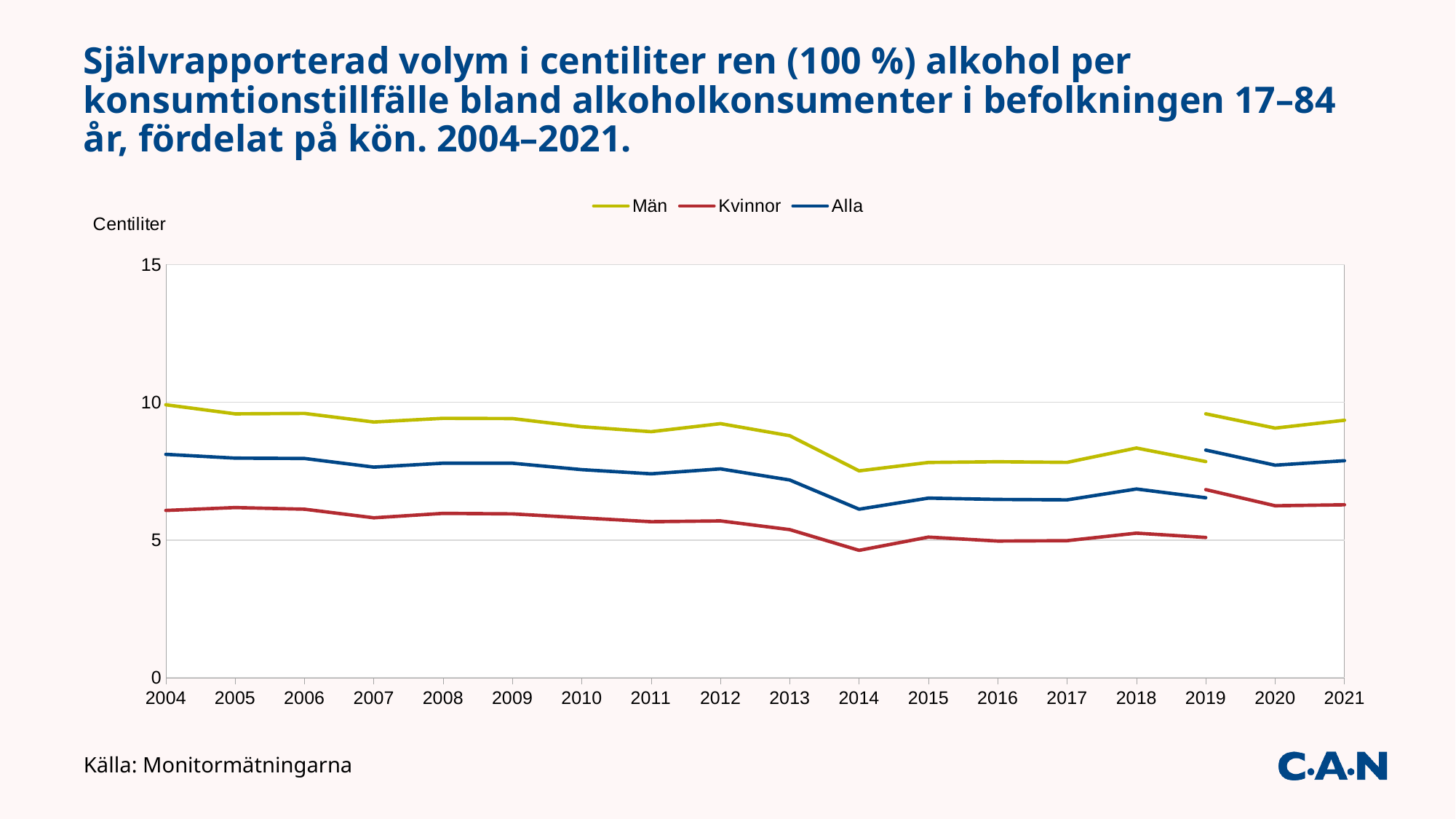
How many series does the legend list? 3 Is the value for Alla in 2004 greater or less than 5? greater Does the value for Män rise or fall from 2004 to 2014? fall What source is cited at the bottom of the slide? Monitormätningarna Which series has the highest values throughout the chart? Män Which series has the lowest values throughout the chart? Kvinnor In 2010, which is larger, the value for Män or the value for Kvinnor? Män What kind of chart is shown on the slide? Line chart What is the label on the y axis? Centiliter How many years are shown on the x axis? 18 Is the value for Kvinnor in 2014 greater or less than 5? less